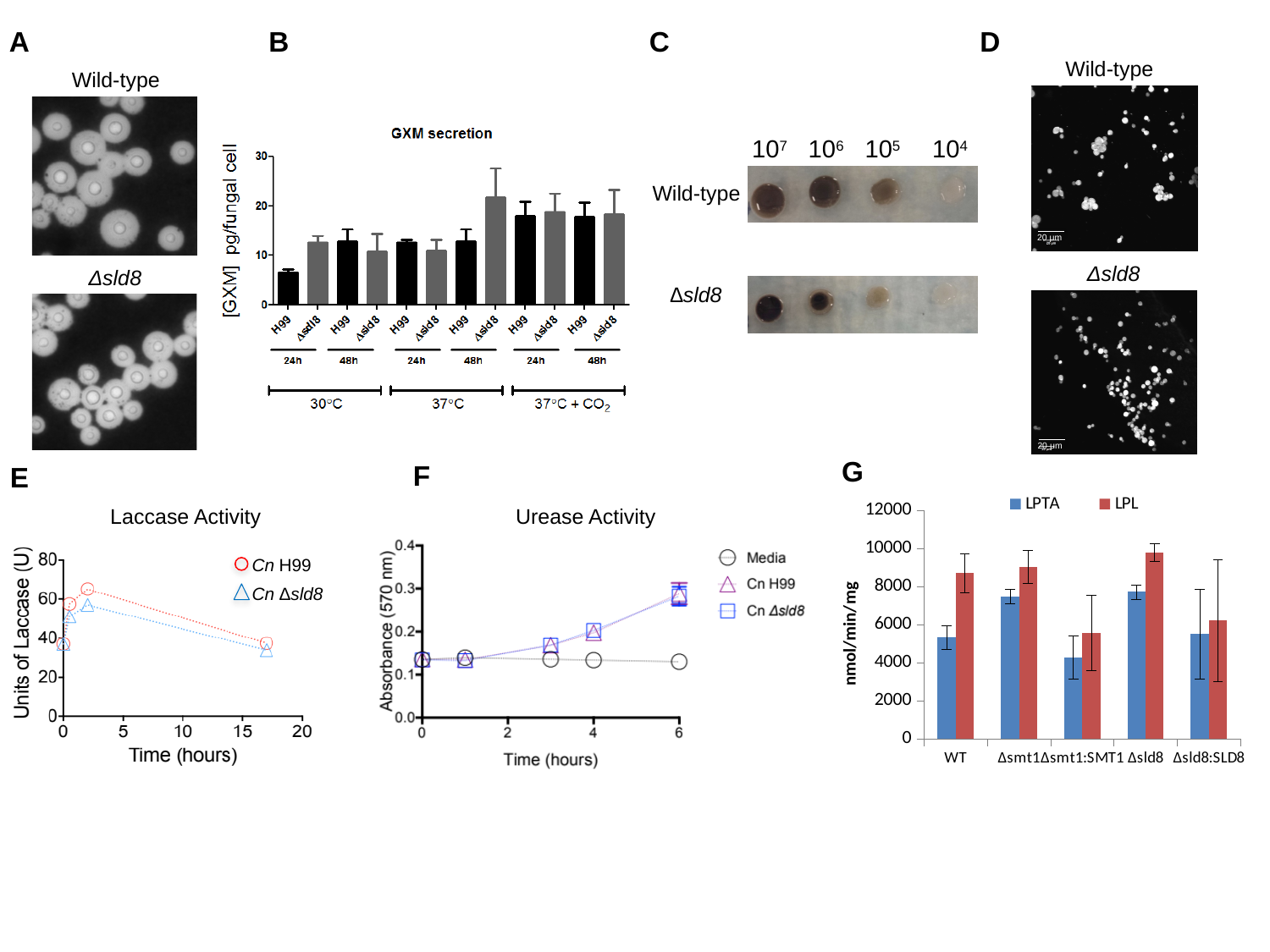
In the GXM secretion chart (panel B), which bar is the lowest? H99 at 24h, 30°C In the Urease Activity chart (panel F), how many series does the legend list? 3 In the Urease Activity chart (panel F), does the Cn Δsld8 series rise or fall over time? rise In the bar chart in panel G, how many categories are shown on the x axis? 5 In the bar chart in panel G, is the LPL value for Δsld8 greater or less than 8000? greater In the Urease Activity chart (panel F), at 6 hours, which is larger: Cn H99 or Media? Cn H99 In the GXM secretion chart (panel B), how many temperature conditions are shown along the x axis? 3 In the GXM secretion chart (panel B), what kind of chart is shown? bar chart In the GXM secretion chart (panel B), is the value for Δsld8 at 48h at 37°C greater or less than 20? greater In the Laccase Activity chart (panel E), is the value for Cn H99 at 17 hours greater or less than 40? less In the Laccase Activity chart (panel E), how many series does the legend list? 2